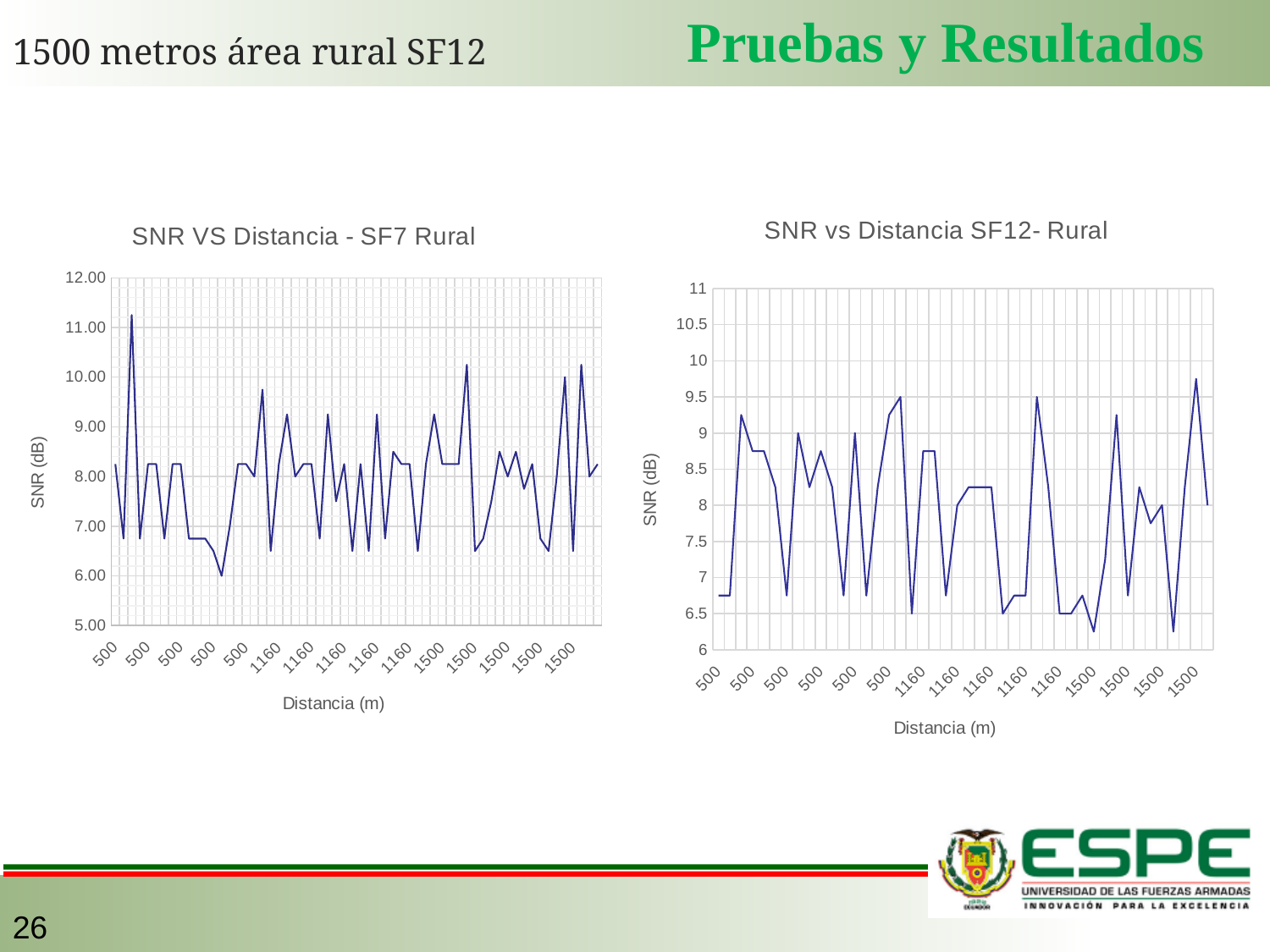
What is the title of the chart on the left side of the slide? SNR VS Distancia - SF7 Rural How many charts are shown on the slide? 2 What kind of chart is the "SNR VS Distancia - SF7 Rural" chart on the left? line chart What kind of chart is the "SNR vs Distancia SF12- Rural" chart on the right? line chart In the "SNR vs Distancia SF12- Rural" chart, is the first plotted value (at the leftmost 500 m point) greater or less than 7? less In the "SNR vs Distancia SF12- Rural" chart, is the lowest SNR value greater or less than 7? less What is the y-axis label of the "SNR vs Distancia SF12- Rural" chart? SNR (dB) In the "SNR VS Distancia - SF7 Rural" chart, is the lowest SNR value greater or less than 7.00? less